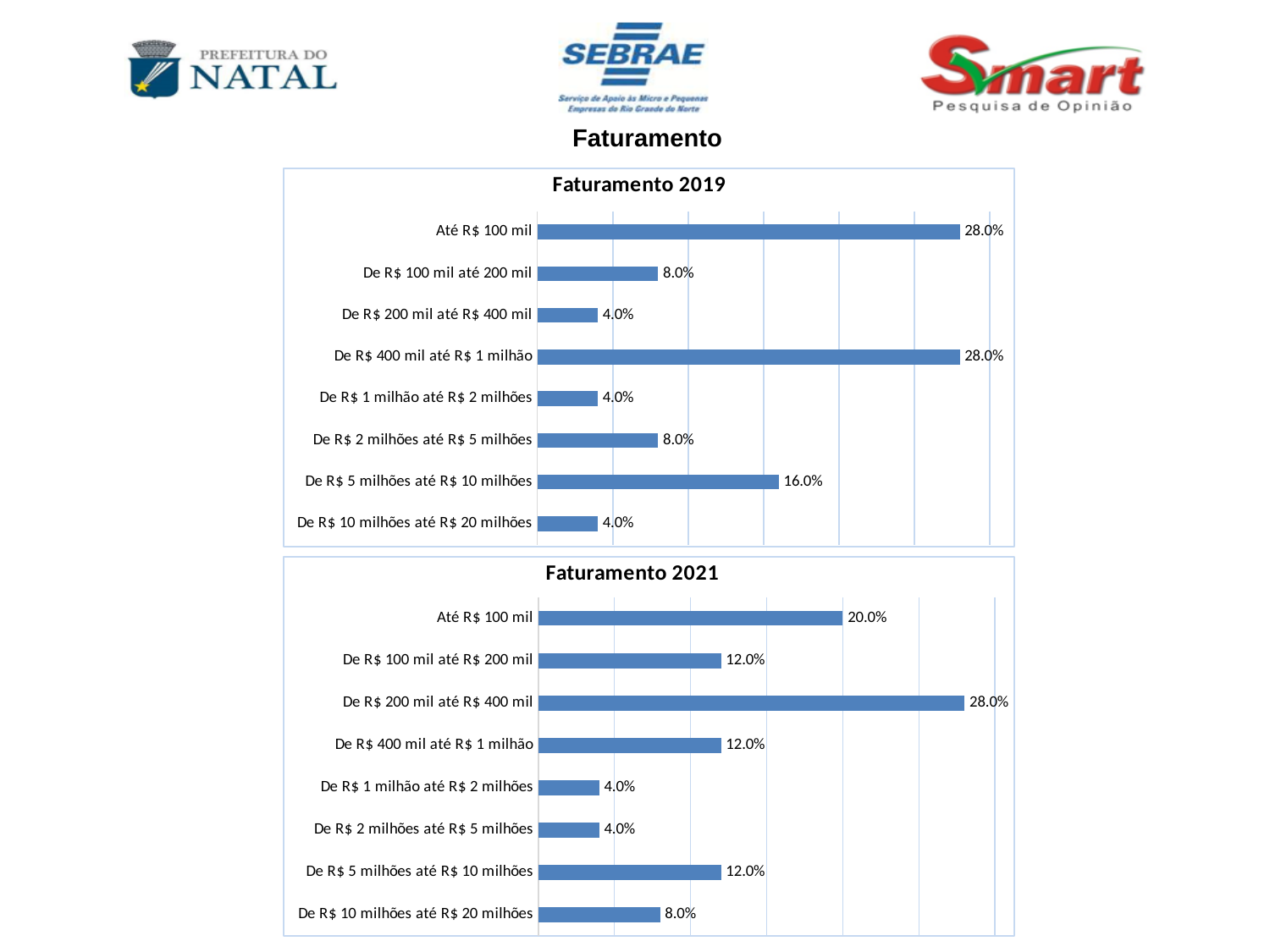
In the Faturamento 2021 chart, what is the value for De R$ 200 mil até R$ 400 mil? 28.0% In the Faturamento 2021 chart, which category has the highest value? De R$ 200 mil até R$ 400 mil In the Faturamento 2021 chart, what is the difference between the values for Até R$ 100 mil and De R$ 100 mil até R$ 200 mil? 8.0% In the Faturamento 2021 chart, which is larger: the value for De R$ 5 milhões até R$ 10 milhões or the value for De R$ 2 milhões até R$ 5 milhões? De R$ 5 milhões até R$ 10 milhões In the Faturamento 2019 chart, which is larger: the value for De R$ 100 mil até 200 mil or the value for De R$ 200 mil até R$ 400 mil? De R$ 100 mil até 200 mil In the Faturamento 2021 chart, what is the value for De R$ 10 milhões até R$ 20 milhões? 8.0% What kind of chart is the Faturamento 2021 chart? Bar chart In the Faturamento 2019 chart, what is the value for Até R$ 100 mil? 28.0% What is the title of the lower chart on the slide? Faturamento 2021 In the Faturamento 2019 chart, what is the difference between the values for Até R$ 100 mil and De R$ 5 milhões até R$ 10 milhões? 12.0% In the Faturamento 2019 chart, what is the value for De R$ 5 milhões até R$ 10 milhões? 16.0% How many categories are shown in the Faturamento 2019 chart? 8